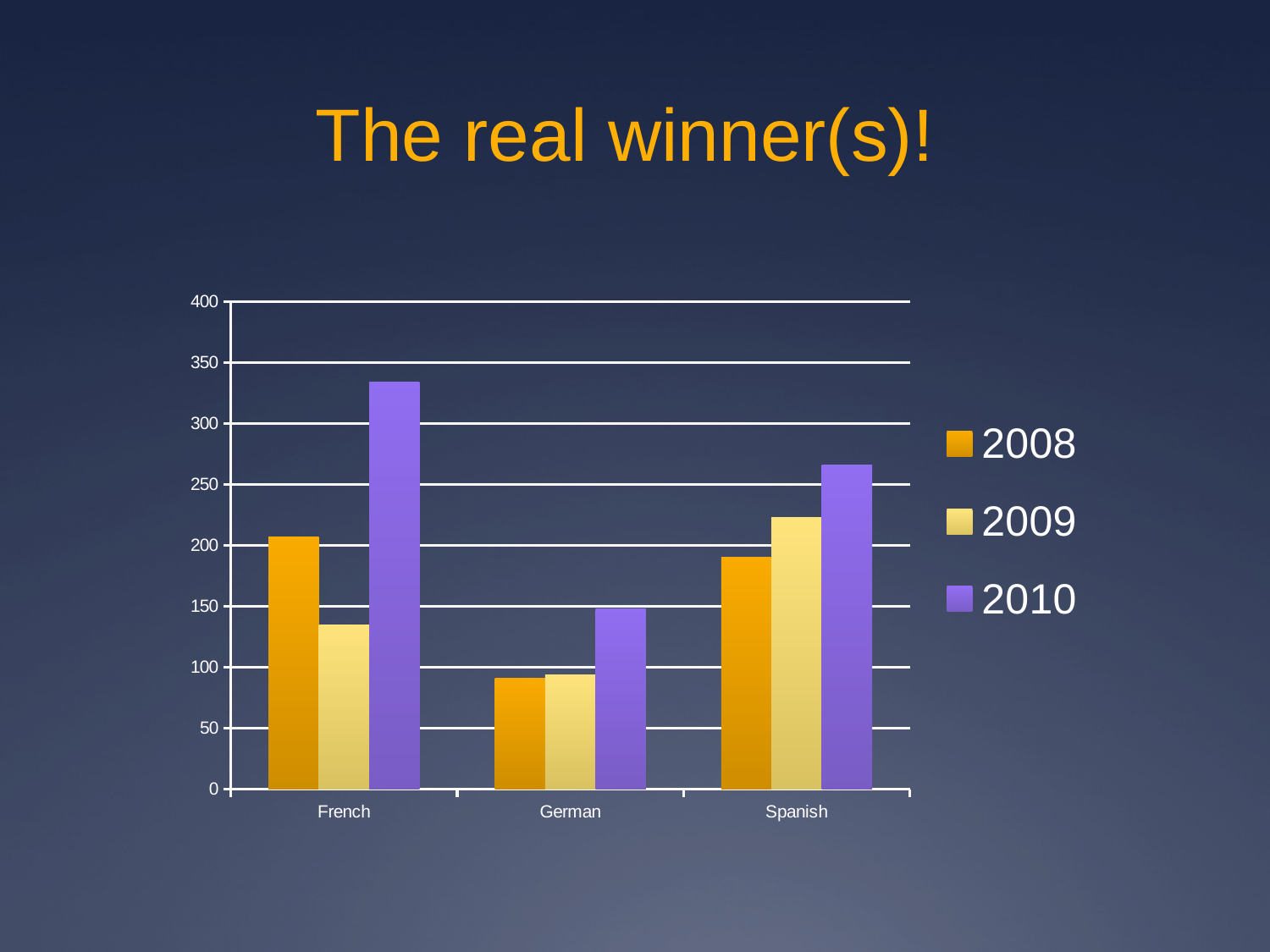
Is the value for German in 2008 greater or less than 100? less Is the value for Spanish in 2010 greater or less than 250? greater Which category has the highest value for the 2009 series? Spanish Do the values for Spanish rise or fall from 2008 to 2010? rise What kind of chart is shown on the slide? bar chart How many categories are shown on the x axis of the chart? 3 How many series does the chart's legend list? 3 Is the value for French in 2010 greater or less than 300? greater Which category has the highest value for the 2010 series? French Which category has the lowest value for the 2008 series? German Which is larger for French: the 2008 value or the 2009 value? 2008 What colour are the bars for the 2010 series? purple